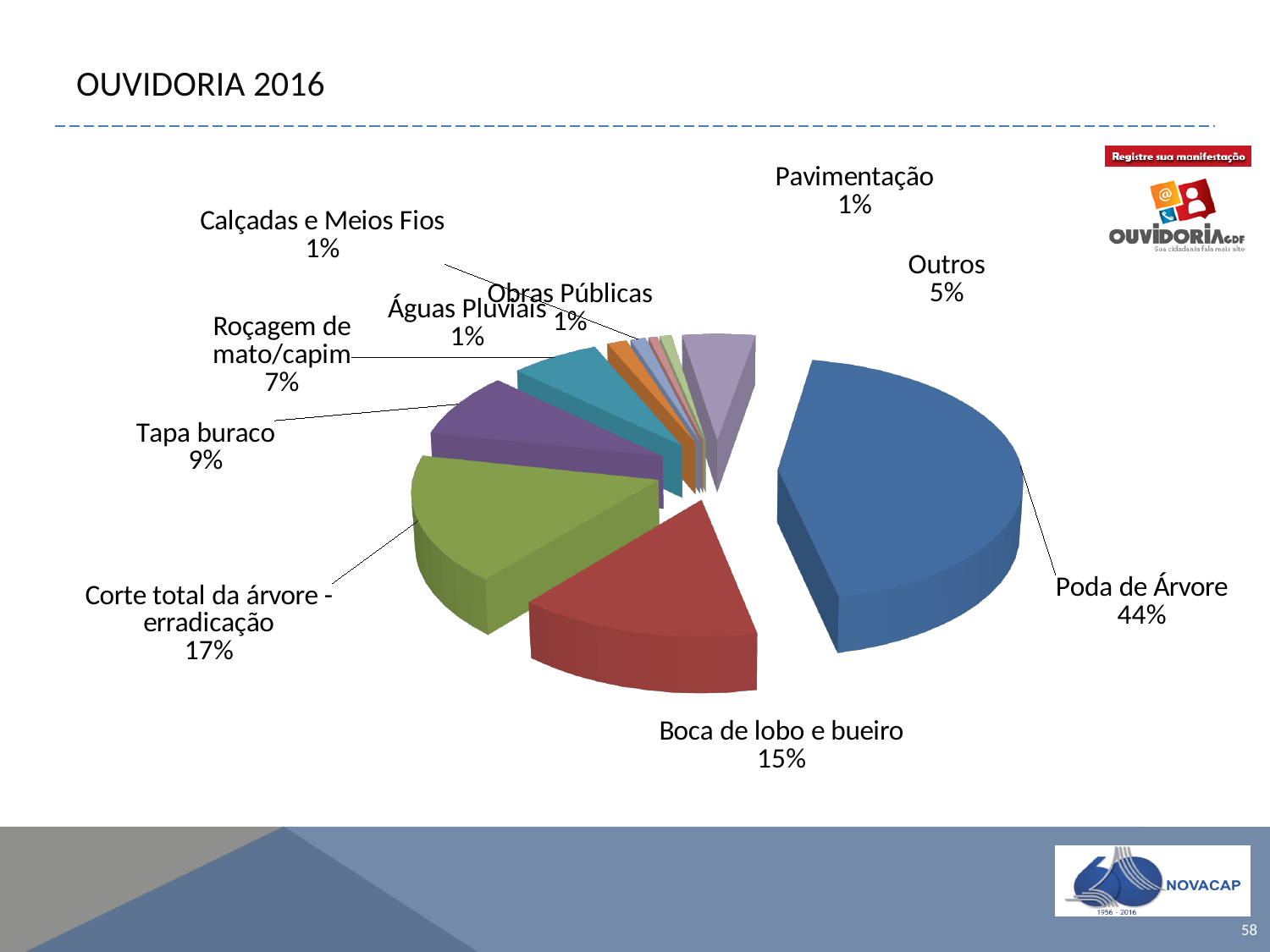
What is the value shown for Tapa buraco? 9% What is the title of the slide containing the pie chart? OUVIDORIA 2016 What is the value shown for Boca de lobo e bueiro? 15% What kind of chart is shown on the slide? Pie chart What is the value shown for Outros? 5% Which is larger, the share for Boca de lobo e bueiro or the share for Tapa buraco? Boca de lobo e bueiro Which category has the largest slice of the pie? Poda de Árvore What is the difference between the shares of Poda de Árvore and Corte total da árvore - erradicação? 27% How many categories are shown in the pie chart? 10 What is the value shown for Corte total da árvore - erradicação? 17% What share of the pie does Poda de Árvore represent? 44% What is the value shown for Roçagem de mato/capim? 7%